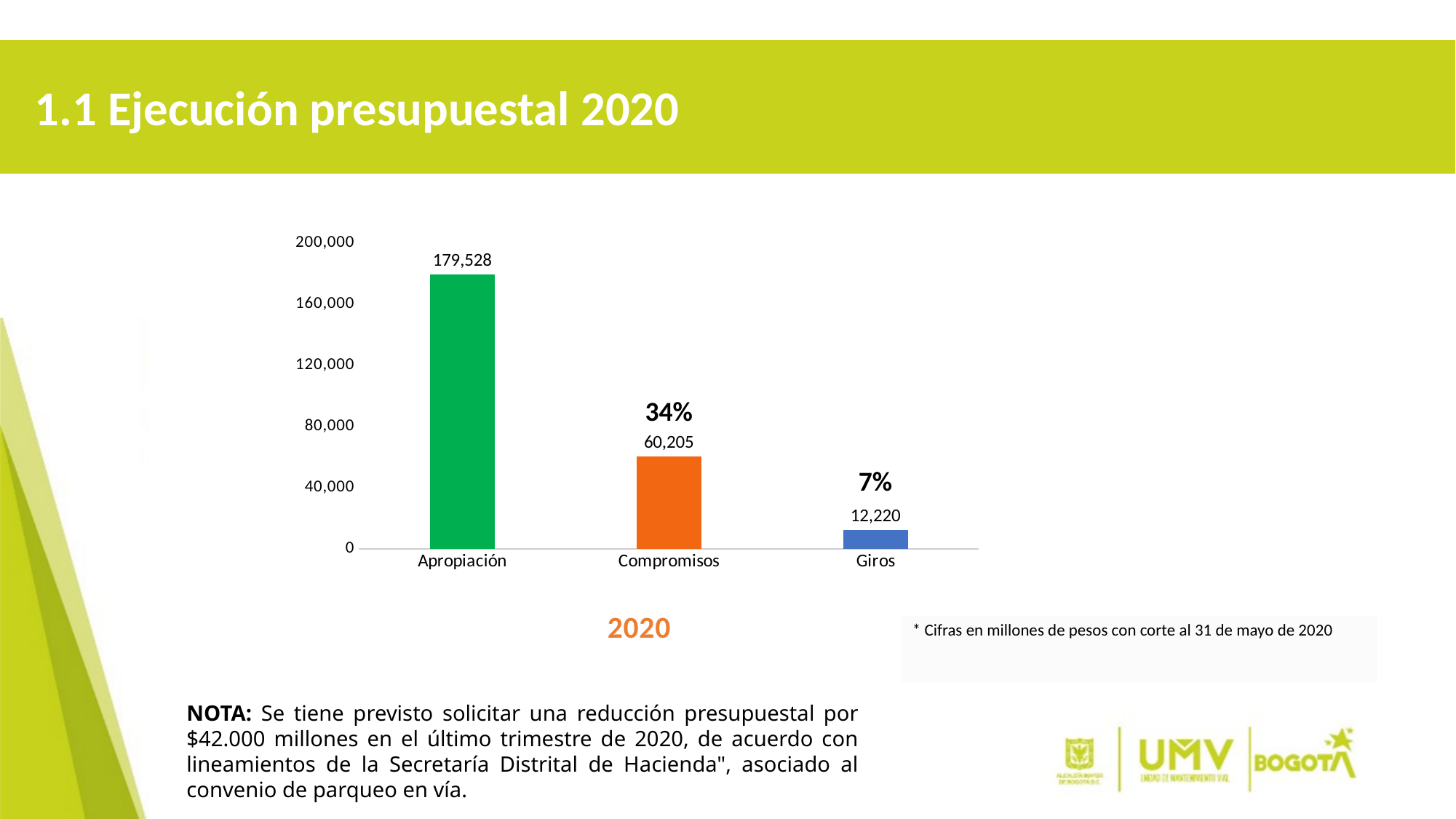
How many categories are shown on the x axis? 3 What is the value for Apropiación? 179,528 What is the value for Compromisos? 60,205 Which is larger, the value for Compromisos or the value for Giros? Compromisos Which category has the highest value? Apropiación Is the value for Compromisos greater or less than 80,000? less What is the difference between the values for Compromisos and Giros? 47,985 Which category has the lowest value? Giros What is the difference between the values for Apropiación and Compromisos? 119,323 What is the value for Giros? 12,220 What percentage label is shown above the Giros bar? 7% What kind of chart is shown on the slide? bar chart